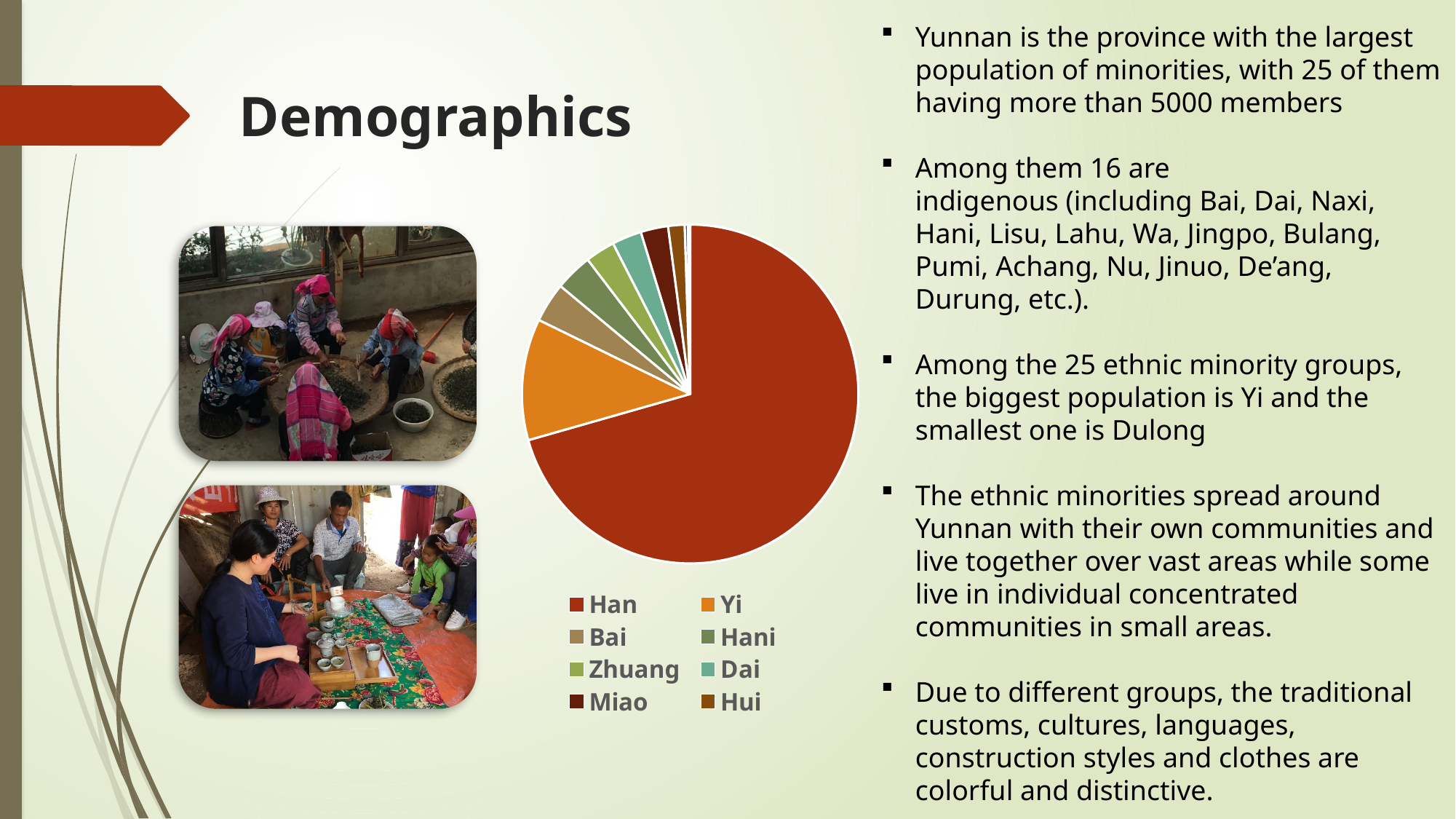
Which ethnic group is the second-largest slice in the pie chart? Yi How many categories does the pie chart's legend list? 8 Is the Han slice greater or less than half of the pie chart? greater Which slice is larger in the pie chart, Yi or Hui? Yi Which slice is larger in the pie chart, Yi or Bai? Yi What kind of chart is shown on the slide? pie chart Which ethnic group has the largest slice in the pie chart? Han What colour represents Han in the pie chart's legend? dark red Which slice is larger in the pie chart, Han or Yi? Han